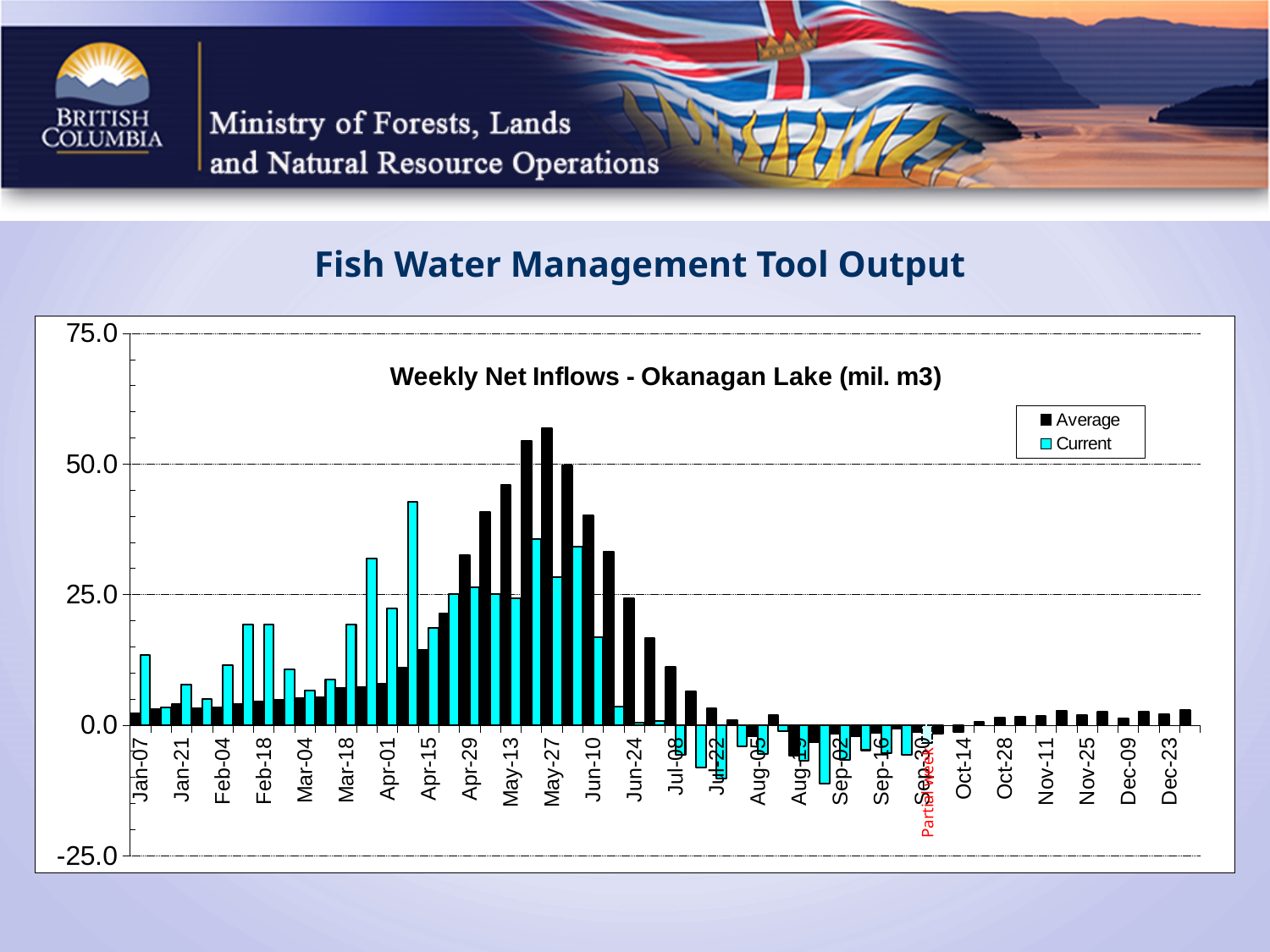
How many series does the legend list? 2 Is the Average value for Dec-23 greater or less than 25.0? less At Jun-10, which series has the larger value, Average or Current? Average What kind of chart is shown on the slide? Bar chart What is the title of the chart? Weekly Net Inflows - Okanagan Lake (mil. m3) Is the Current value for Apr-01 greater or less than 25.0? less Is the Current value for Jul-22 greater or less than 0.0? less At Apr-01, which series has the larger value, Average or Current? Current Do the Average values rise or fall from Jun-10 to Jul-22? Fall Which colour represents the Current series in the legend? Cyan (light blue)